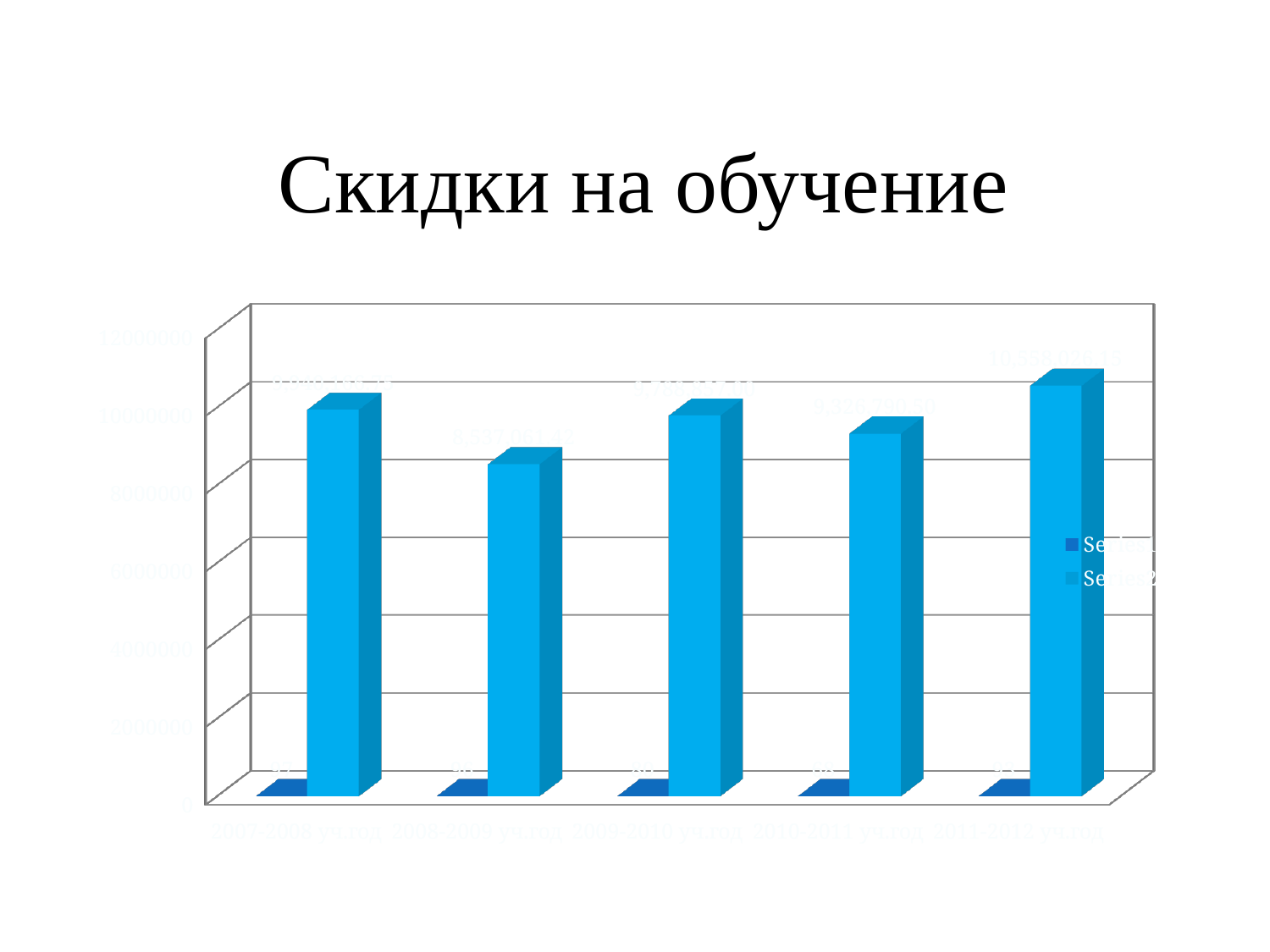
Which is larger, the value for 2009-2010 уч.год or for 2010-2011 уч.год? 2009-2010 уч.год Which academic year has the tallest bar? 2011-2012 уч.год Is the value for 2011-2012 уч.год greater or less than 10000000? greater How many academic-year categories are shown on the x axis? 5 What kind of chart is shown on the slide? bar chart Which is larger, the value for 2007-2008 уч.год or for 2008-2009 уч.год? 2007-2008 уч.год Is the value for 2008-2009 уч.год greater or less than 10000000? less Is the value for 2010-2011 уч.год greater or less than 10000000? less What are the two entries listed in the legend? Series1, Series2 How many series does the legend list? 2 Which academic year has the shortest tall (light blue) bar? 2008-2009 уч.год What is the title of the chart? Скидки на обучение